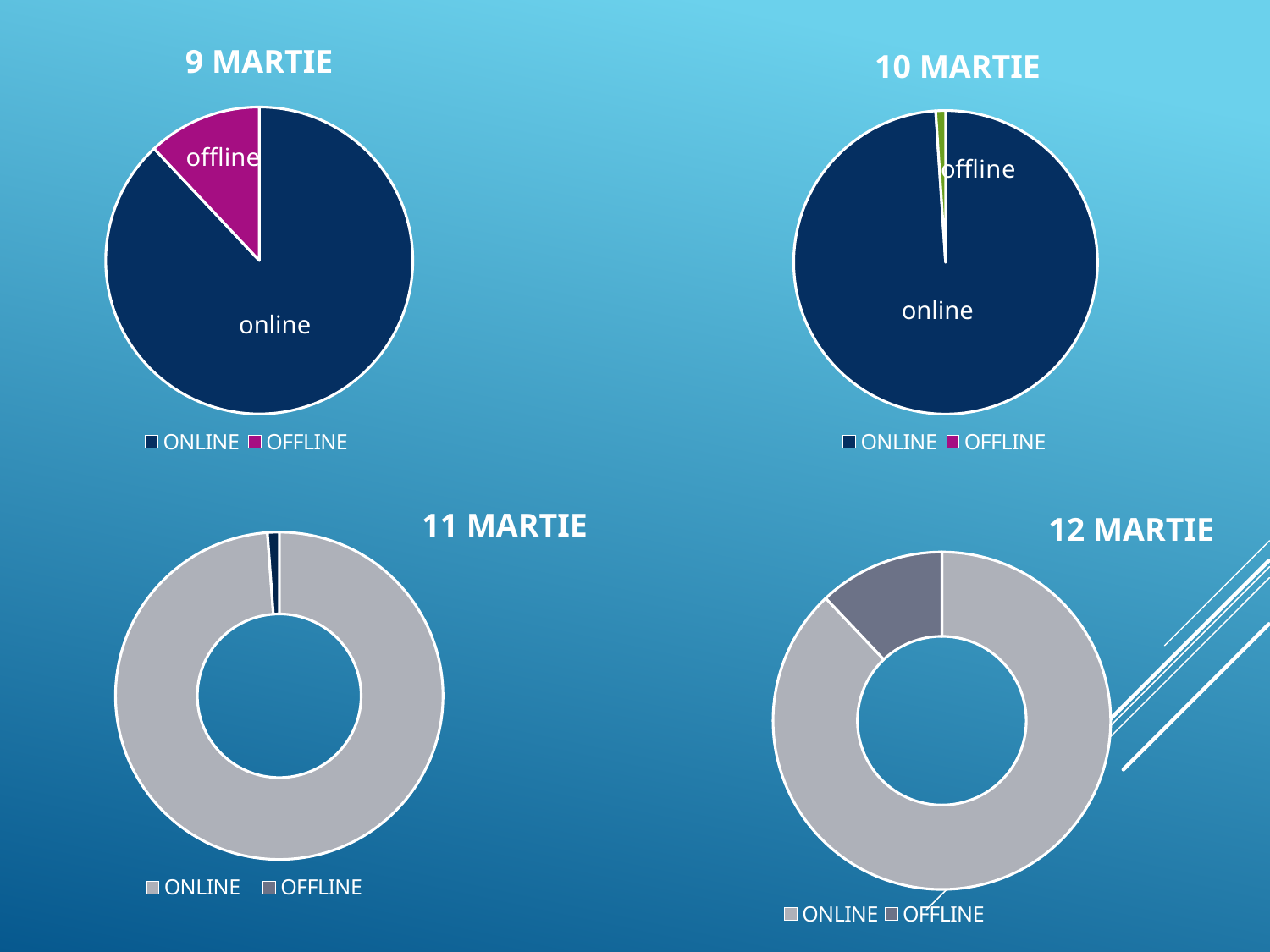
How many charts are on the slide? 4 How many categories does the "12 MARTIE" chart show? 2 What kind of chart is the "9 MARTIE" chart? pie chart What are the two legend entries of the "9 MARTIE" chart? ONLINE and OFFLINE In the "12 MARTIE" chart, which is larger, ONLINE or OFFLINE? ONLINE In the "9 MARTIE" chart, which category has the smallest slice? offline In the "9 MARTIE" chart, which category has the largest slice? online What kind of chart is the "11 MARTIE" chart? doughnut chart In the "10 MARTIE" chart, which category has the largest slice? online In the "11 MARTIE" chart, which category has the smallest share? OFFLINE How many entries does the legend of the "10 MARTIE" chart list? 2 What is the title of the chart in the top-right of the slide? 10 MARTIE